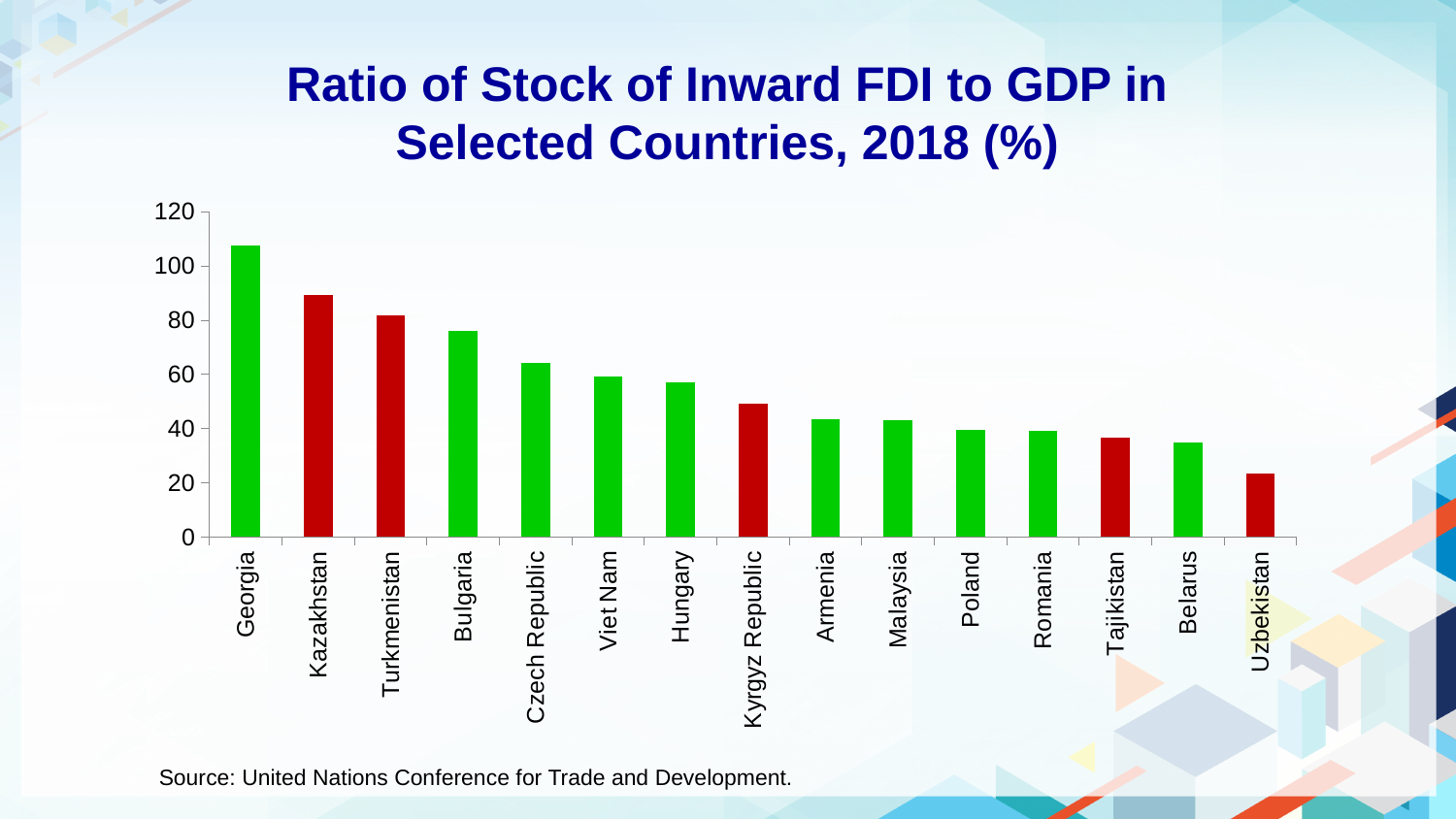
Do the values rise or fall moving from left to right along the x axis? Fall Which country has the highest ratio of stock of inward FDI to GDP? Georgia Is the value for Kyrgyz Republic greater or less than 60? less Which country has the lowest ratio of stock of inward FDI to GDP? Uzbekistan What kind of chart is shown on the slide? Bar chart Is the value for Czech Republic greater or less than 60? greater What is the title of the chart? Ratio of Stock of Inward FDI to GDP in Selected Countries, 2018 (%) Is the value for Georgia greater or less than 100? greater How many countries are shown on the chart? 15 Which is larger, the value for Turkmenistan or the value for Bulgaria? Turkmenistan